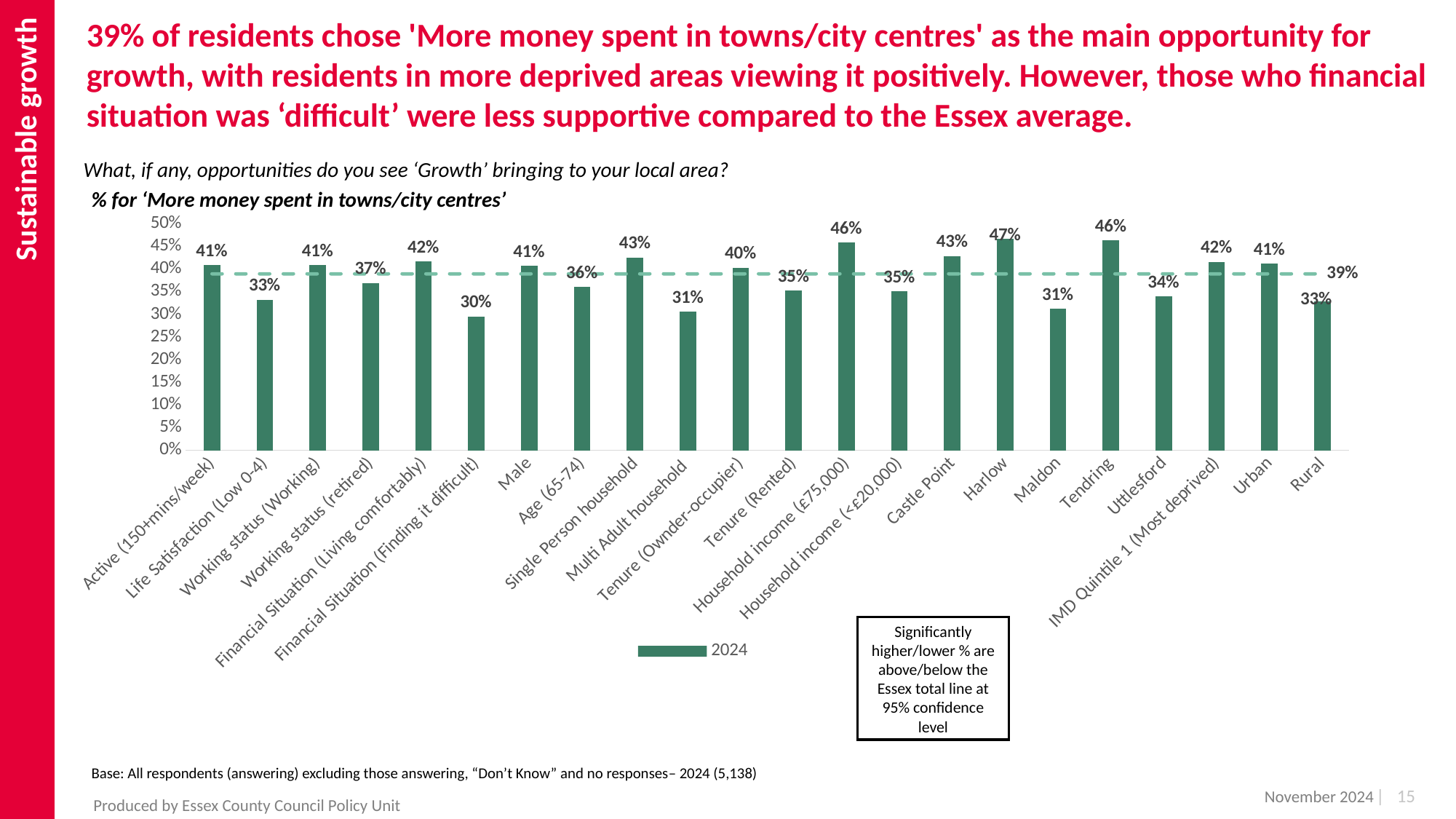
How many categories are shown on the x axis? 22 What percentage is shown for Household income (£75,000)? 46% What is the value for Financial Situation (Finding it difficult)? 30% What is the value for Rural? 33% Is the value for Multi Adult household greater or less than 35%? less What percentage is shown for Harlow? 47% Which category has the highest percentage? Harlow What value does the dashed horizontal line represent? 39% What type of chart is this? Bar chart Which is larger, Castle Point or Maldon? Castle Point Which category has the lowest percentage? Financial Situation (Finding it difficult) What is the difference between Tendring and Uttlesford? 12 percentage points